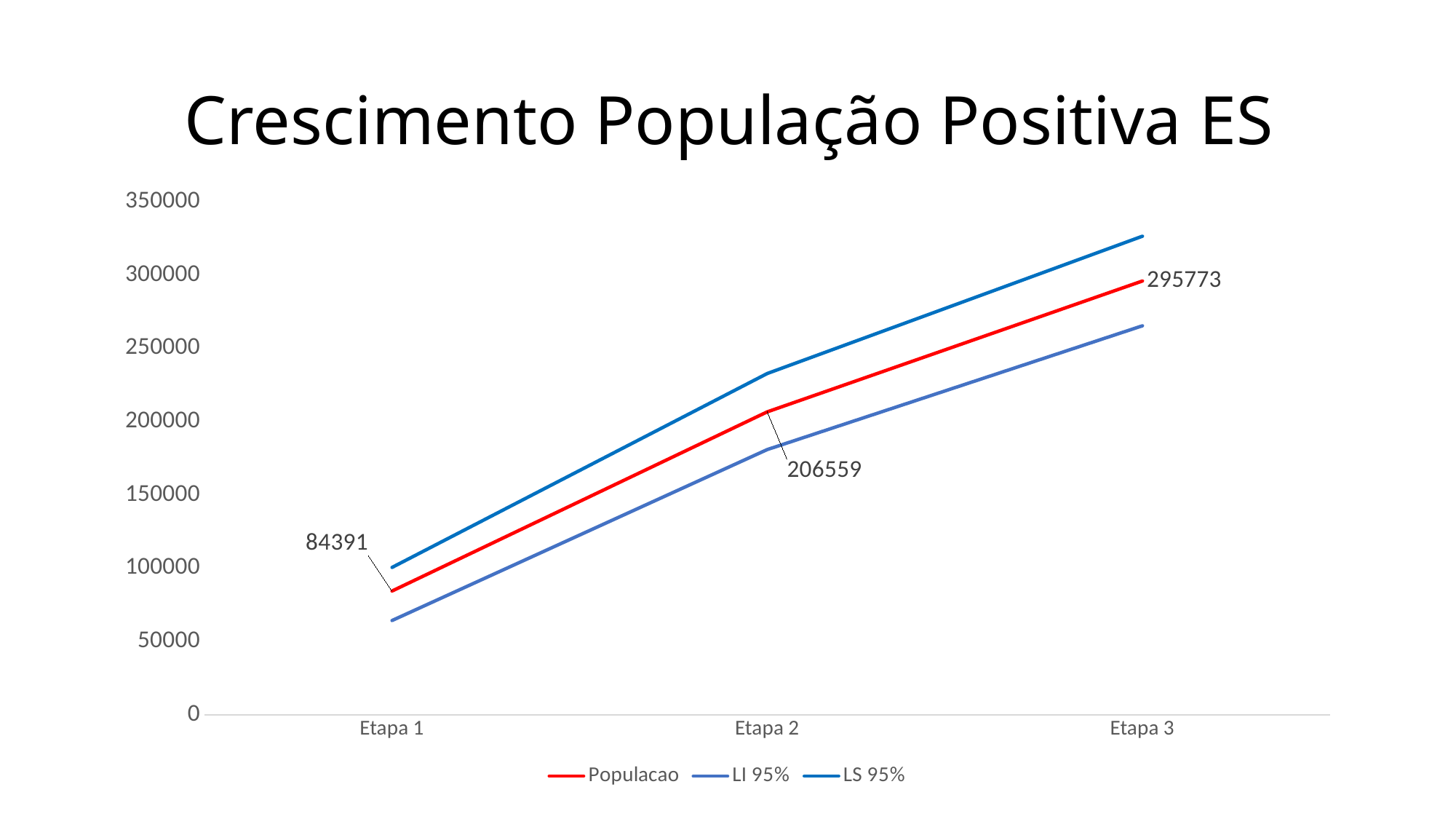
Which is larger for the Populacao series: the value at Etapa 2 or at Etapa 3? Etapa 3 What is the difference between the Populacao values at Etapa 3 and Etapa 1? 211382 At which Etapa is the Populacao series highest? Etapa 3 Is the value of LS 95% at Etapa 3 greater or less than 300000? greater What is the value of the Populacao series at Etapa 3? 295773 Is the value of LI 95% at Etapa 1 greater or less than 100000? less What is the value of the Populacao series at Etapa 2? 206559 Do the values of the Populacao series rise or fall from Etapa 1 to Etapa 3? Rise How many series does the legend list? 3 What kind of chart is shown on the slide? Line chart At which Etapa is the Populacao series lowest? Etapa 1 What is the value of the Populacao series at Etapa 1? 84391